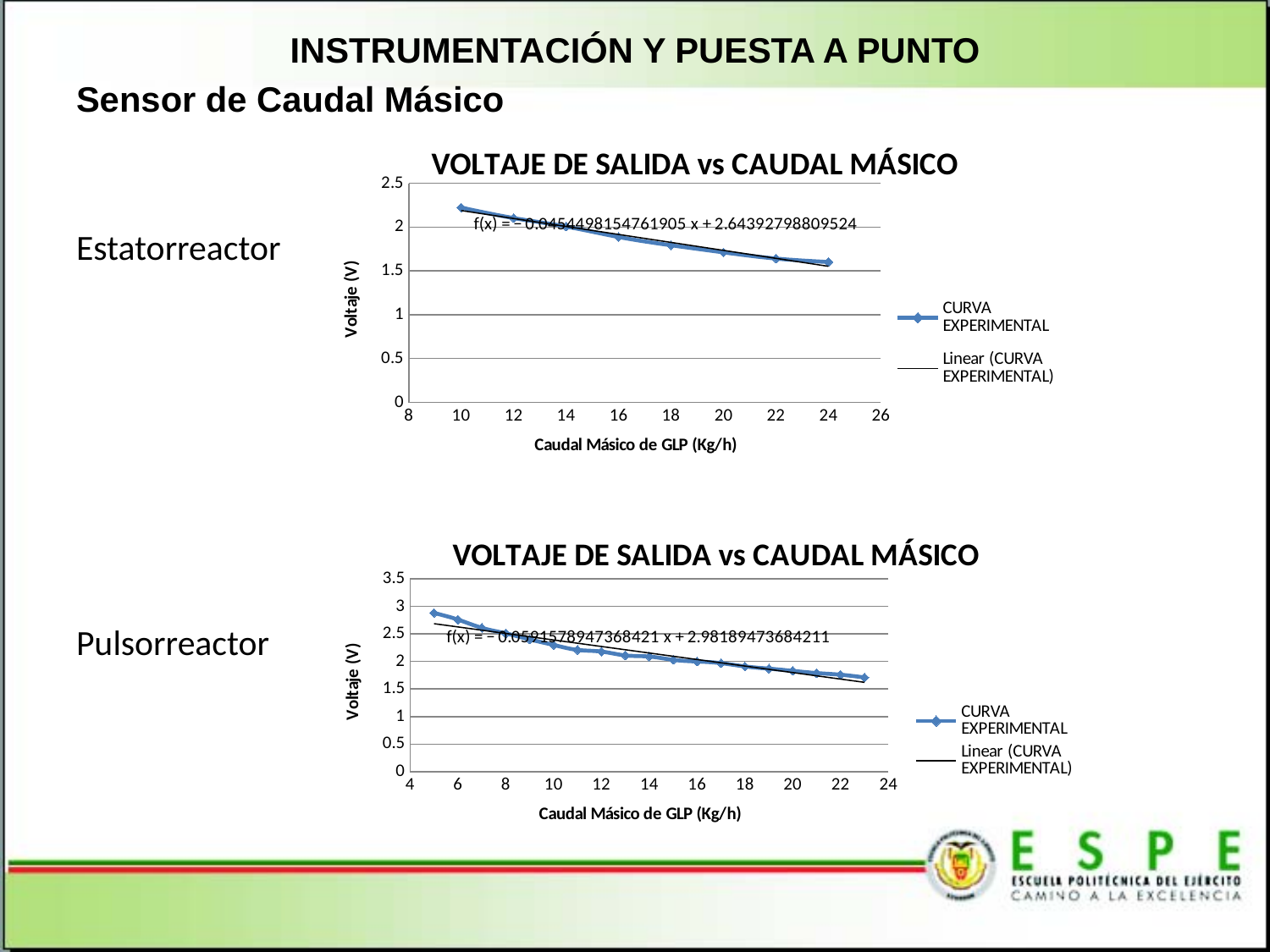
In the bottom chart (Pulsorreactor), is the voltage at a mass flow of 5 Kg/h greater or less than 2.5 V? greater What type of chart is the top chart (Estatorreactor)? Line chart In the top chart (Estatorreactor), is the voltage at a mass flow of 10 Kg/h greater or less than 2 V? greater In the top chart (Estatorreactor), does the output voltage rise or fall as the mass flow increases along the x axis? Fall What is the title of the bottom chart (Pulsorreactor)? VOLTAJE DE SALIDA vs CAUDAL MÁSICO What is the x-axis title of the bottom chart (Pulsorreactor)? Caudal Másico de GLP (Kg/h) In the top chart (Estatorreactor), is the voltage at a mass flow of 24 Kg/h greater or less than 2 V? less In the bottom chart (Pulsorreactor), does the voltage rise or fall as the mass flow increases along the x axis? Fall How many data points are plotted on the CURVA EXPERIMENTAL series in the top chart (Estatorreactor)? 8 How many series does the legend of the top chart (Estatorreactor) list? 2 In the top chart (Estatorreactor), which has the higher voltage: the point at 10 Kg/h or the point at 24 Kg/h? 10 Kg/h